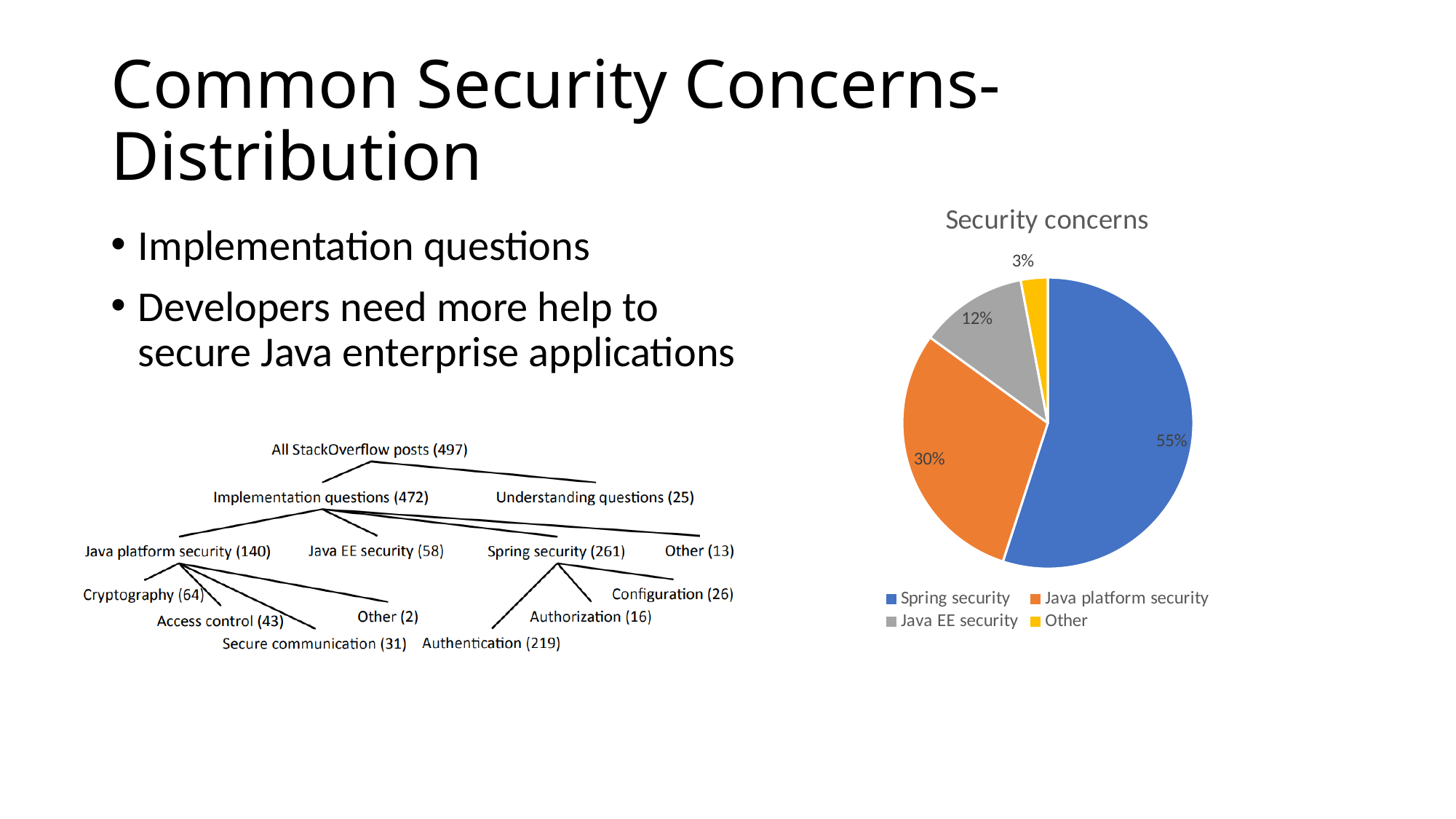
What share of the pie does Java platform security have? 30% What type of chart is shown on the slide? pie chart How many categories does the pie chart legend list? 4 What share of the pie does Other have? 3% What is the difference in percentage points between Spring security and Java platform security? 25 What is the title of the pie chart? Security concerns Which category has the smallest slice of the pie? Other What share of the pie does Spring security have? 55% What colour is the Java platform security slice? orange Which category has the largest slice of the pie? Spring security Which is larger, the share for Java EE security or the share for Other? Java EE security What share of the pie does Java EE security have? 12%